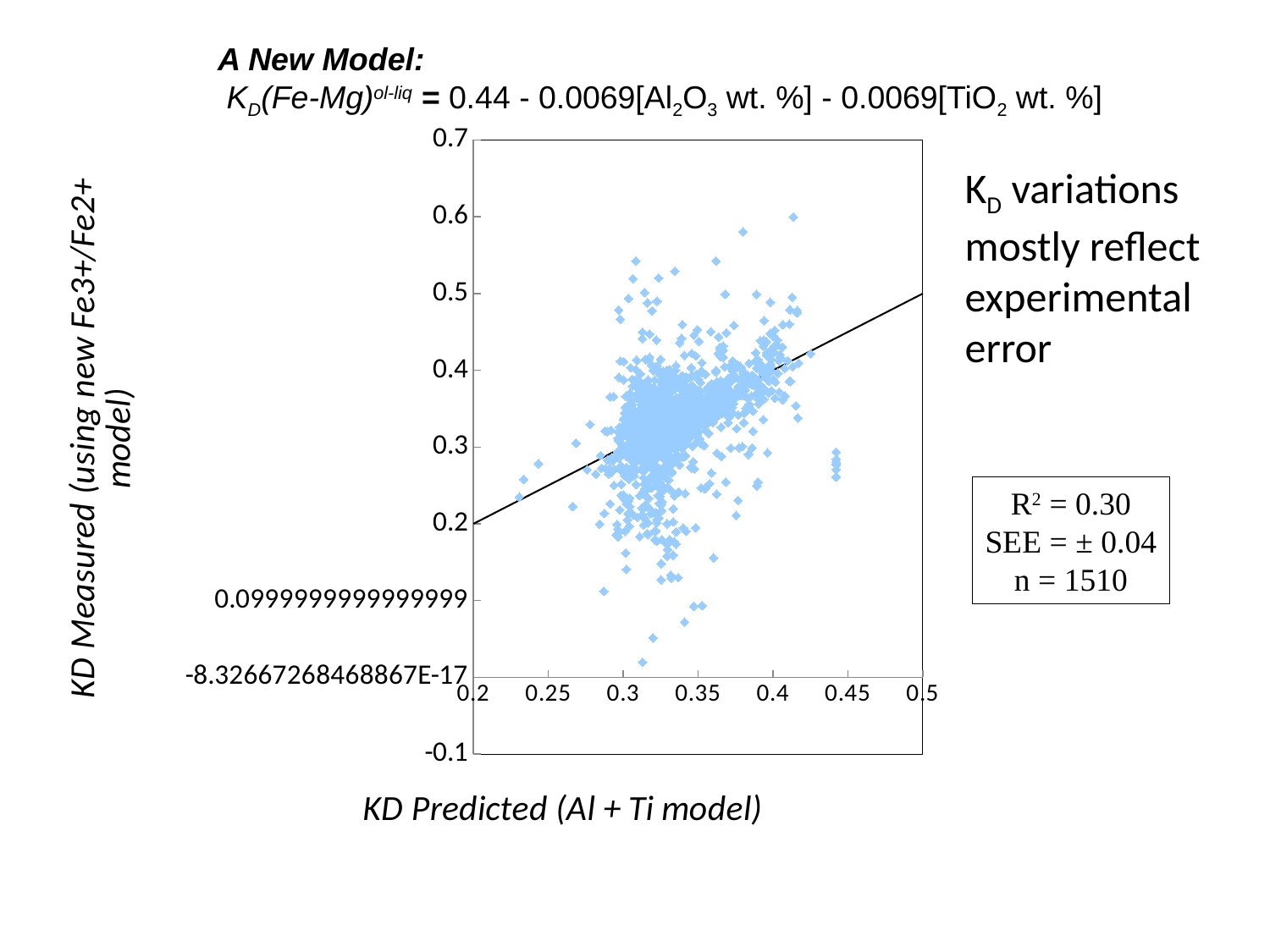
Is the lowest KD Measured value plotted in the chart greater or less than 0.1? less Is the value of the fitted line at KD Predicted = 0.2 greater or less than 0.3? less Is the value of the fitted line at KD Predicted = 0.5 greater or less than 0.4? greater What is the maximum value shown on the x axis of the chart? 0.5 How many data points (n) does the slide state are plotted in the chart? 1510 What is the title of the y axis of the chart? KD Measured (using new Fe3+/Fe2+ model) What is the title of the x axis of the chart? KD Predicted (Al + Ti model) Do the points in the chart generally rise or fall as KD Predicted increases along the x axis? rise What R² value is reported for the fit shown in the chart? 0.30 What SEE value is reported for the fit shown in the chart? ± 0.04 What kind of chart is shown on the slide? scatter plot